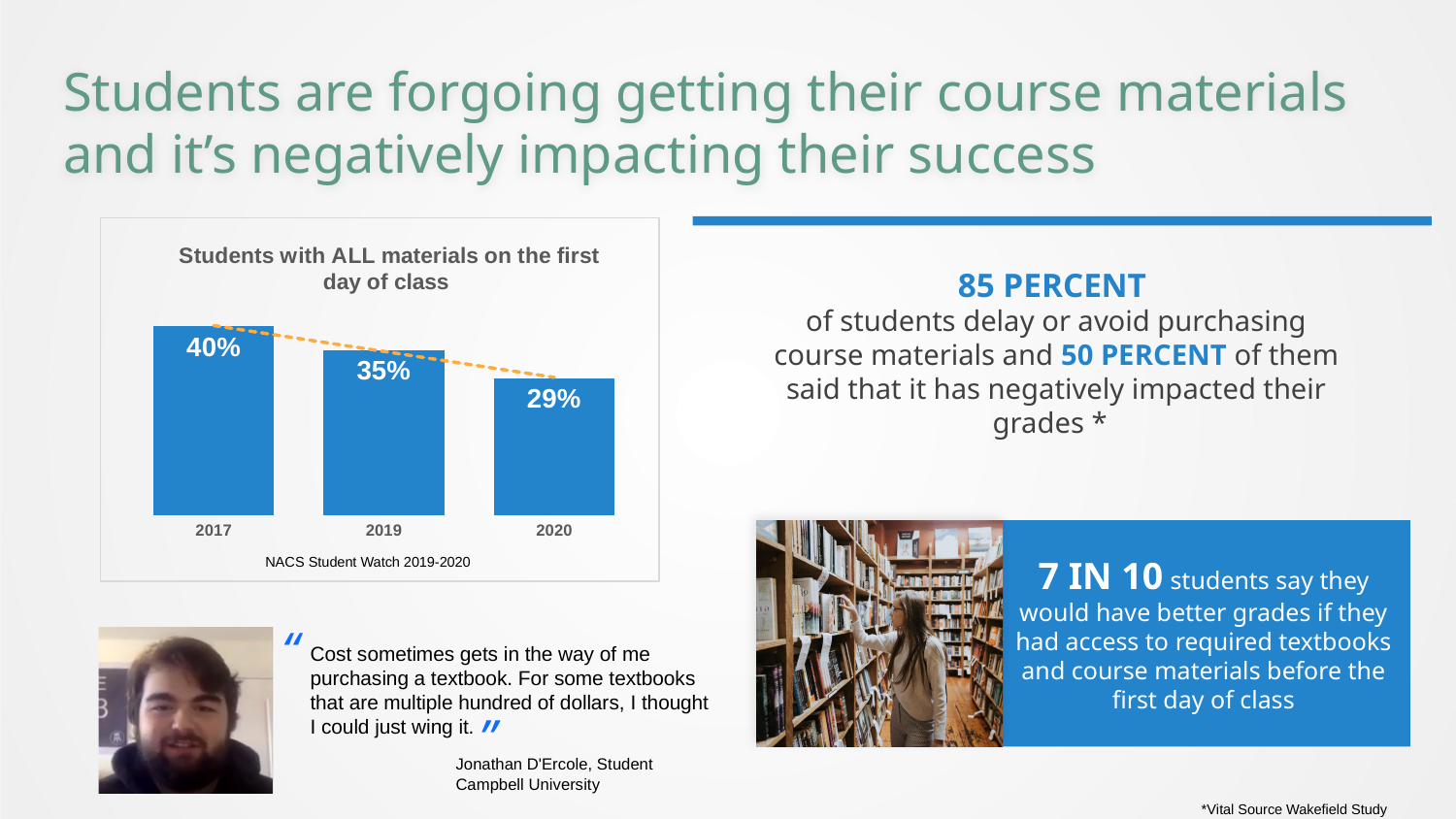
Which year has a larger value, 2019 or 2020? 2019 What is the title of the chart? Students with ALL materials on the first day of class What is the value shown for 2020 in the chart? 29% What is the difference in percentage points between 2017 and 2020? 11 How many years are shown in the chart? 3 What kind of chart is shown on the slide? Bar chart What percentage of students had all materials on the first day of class in 2017? 40% Do the values rise or fall from 2017 to 2020? Fall Which year has the lowest percentage of students with all materials on the first day of class? 2020 Which year has the highest percentage of students with all materials on the first day of class? 2017 What is the difference in percentage points between 2019 and 2020? 6 What is the value shown for 2019 in the chart? 35%